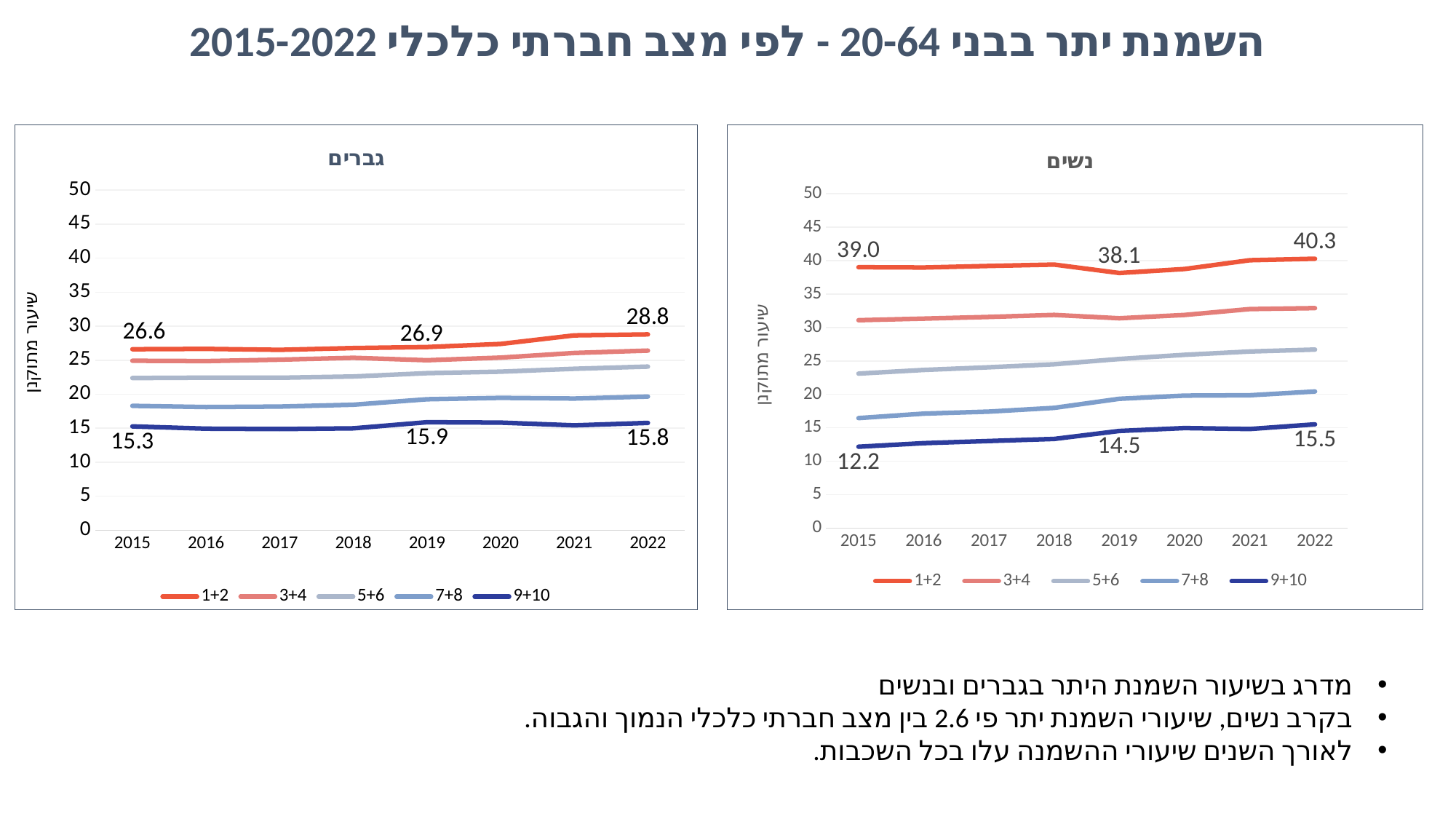
In the נשים chart, what is the difference between the 1+2 value and the 9+10 value in 2022? 24.8 In the גברים chart, what is the value of the 1+2 series in 2022? 28.8 Which is larger: the 1+2 value in 2022 in the נשים chart or the 1+2 value in 2022 in the גברים chart? נשים (40.3) How many series does the legend of the נשים chart list? 5 How many years are shown on the x axis of the גברים chart? 8 In the גברים chart, is the value of the 7+8 series in 2015 greater or less than 20? less In the נשים chart, is the value of the 5+6 series in 2022 greater or less than 25? greater In the גברים chart, by how much did the 1+2 series change from 2015 to 2022? 2.2 What type of chart is the נשים chart? Line chart In the נשים chart, what is the value of the 1+2 series in 2019? 38.1 In the גברים chart, what is the value of the 9+10 series in 2019? 15.9 In the נשים chart, what is the value of the 9+10 series in 2015? 12.2